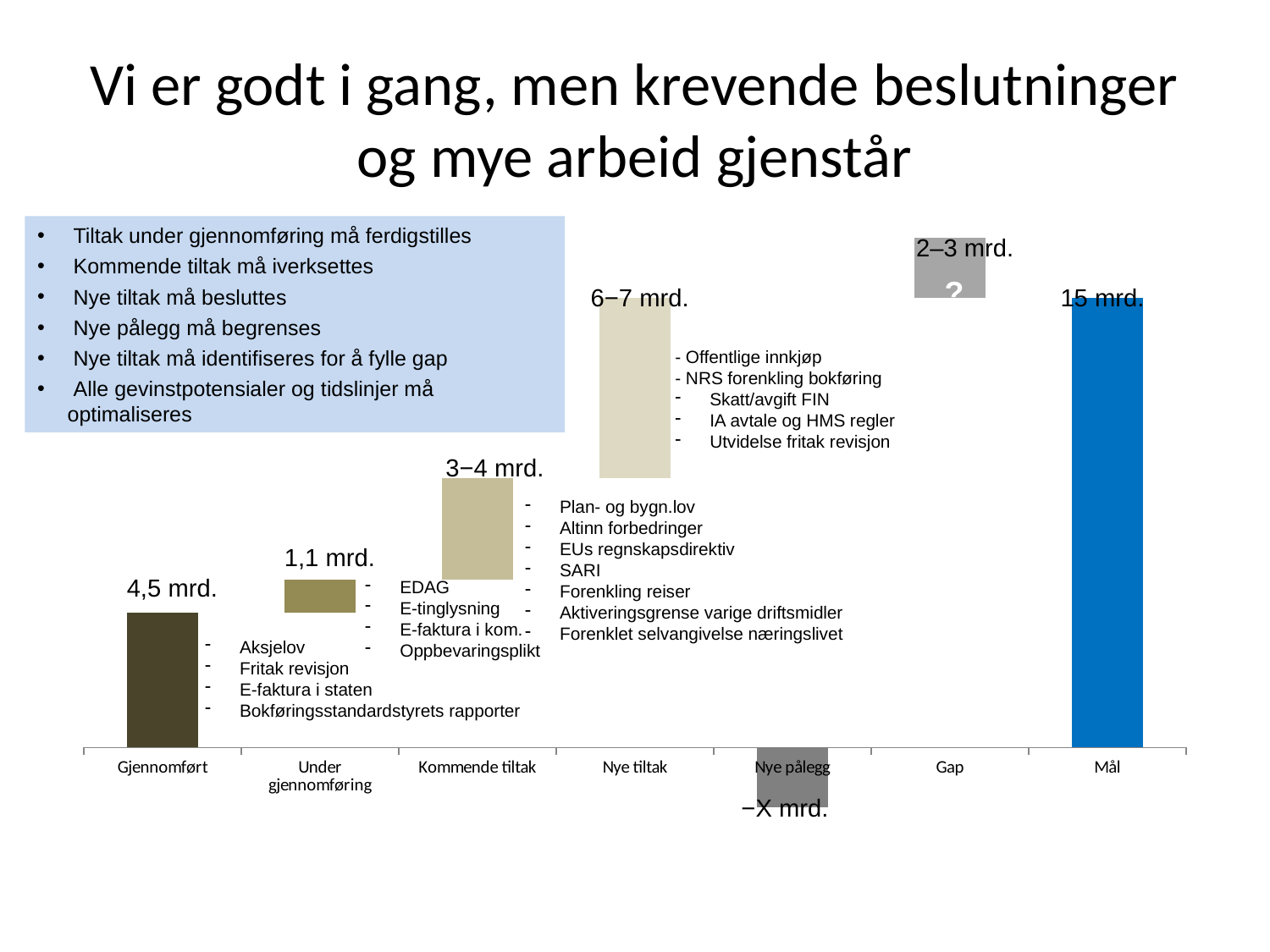
What value is shown for Nye tiltak? 6−7 mrd. How many categories are shown on the x axis of the chart? 7 Which is larger, the value for Gjennomført or for Under gjennomføring? Gjennomført Which category has the highest value in the chart? Mål What is the difference between the Gjennomført value and the Under gjennomføring value? 3,4 mrd. What kind of chart is shown on the slide? Bar chart What value is shown for the Gap bar? 2–3 mrd. What value is shown for the Under gjennomføring bar? 1,1 mrd. What value is shown for the Mål bar? 15 mrd. What colour is the Mål bar? Blue What value is shown for Kommende tiltak? 3−4 mrd. What value is shown for the Gjennomført bar? 4,5 mrd.